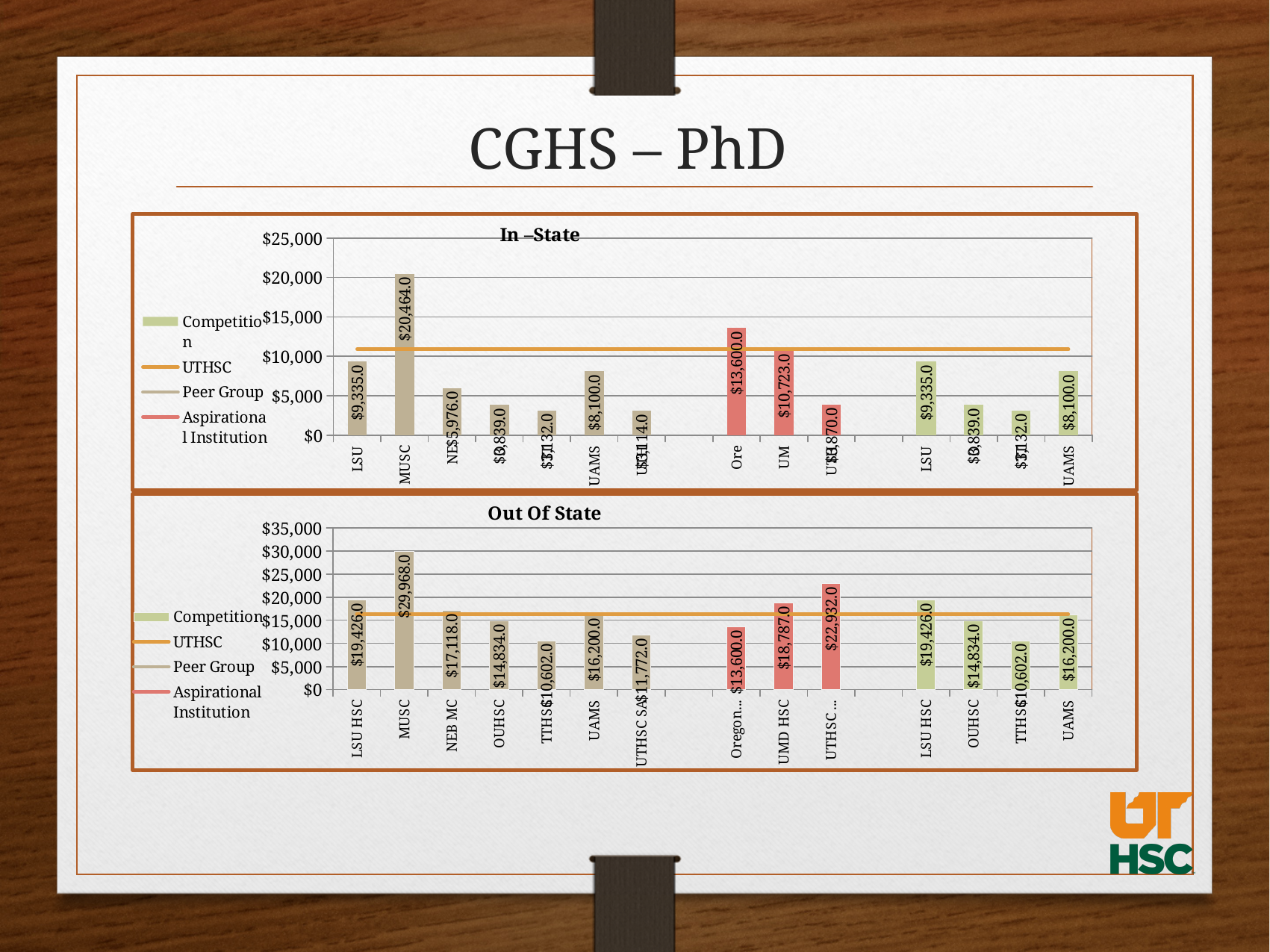
What kind of chart is the Out Of State chart? bar chart In the In –State chart, what is the value for MUSC? $20,464.0 In the In –State chart, which category has the highest value? MUSC In the In –State chart, what is the value for UM? $10,723.0 How many entries does the legend of the Out Of State chart list? 4 In the Out Of State chart, which is larger, the value for UAMS or the value for OUHSC? UAMS In the Out Of State chart, what is the value for MUSC? $29,968.0 In the Out Of State chart, which category has the highest value? MUSC In the Out Of State chart, what is the difference between the values for MUSC and NEB MC? $12,850.0 In the In –State chart, what is the value for Ore? $13,600.0 In the Out Of State chart, what is the value for UMD HSC? $18,787.0 In the In –State chart, is the value for MUSC greater or less than $15,000? greater